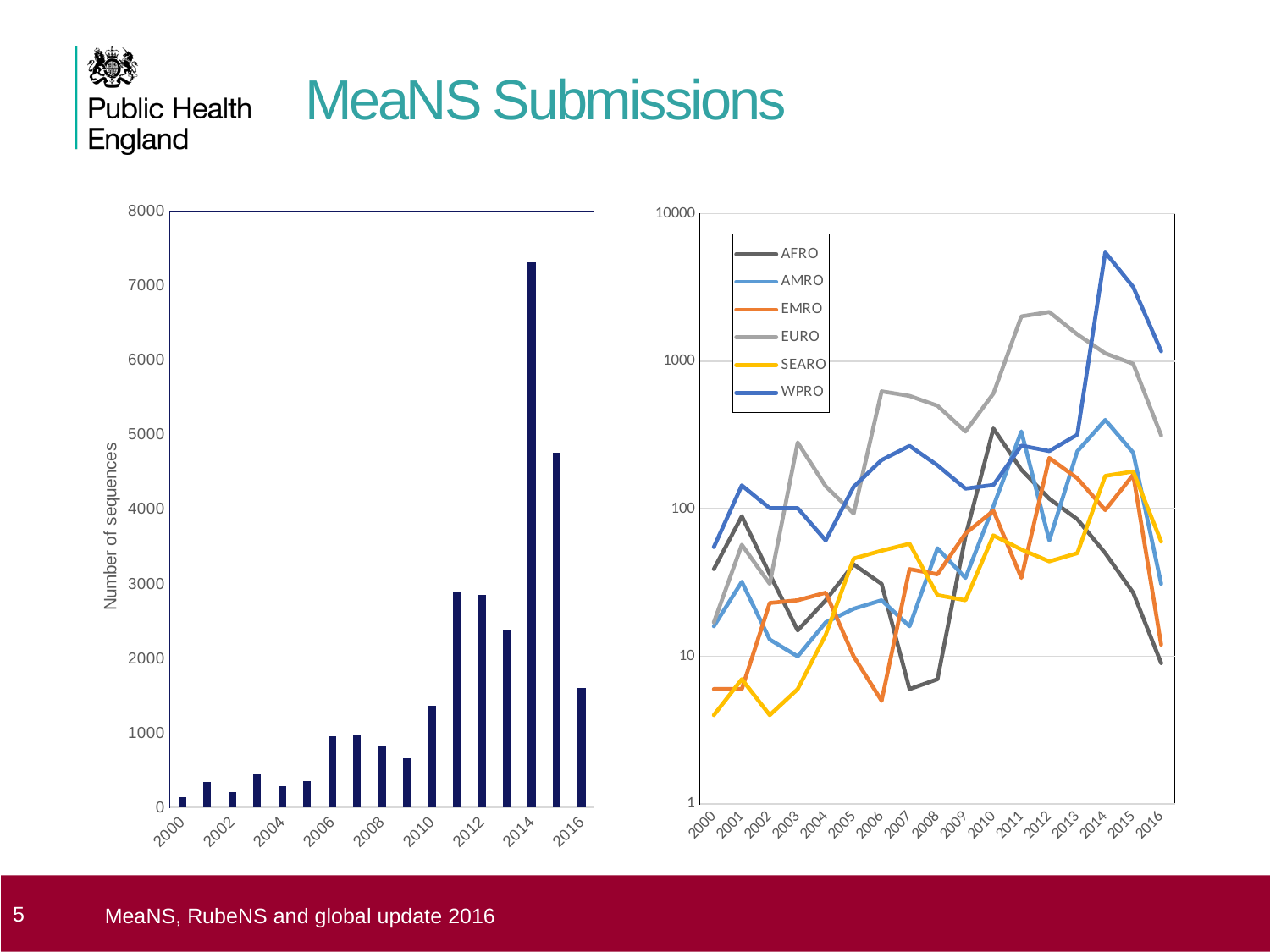
In the right line chart, is the value for WPRO in 2014 greater or less than 1000? greater How many series does the legend of the right line chart list? 6 What kind of chart is the left chart on the slide? bar chart In the left bar chart, is the value for 2016 greater or less than 1000? greater In the left bar chart, which year has the lowest number of sequences? 2000 In the left bar chart, is the value for 2015 greater or less than 5000? less What kind of chart is the right chart on the slide? line chart In the right line chart, which series has the highest value in 2014? WPRO In the left bar chart, which year has the highest number of sequences? 2014 In the left bar chart, which year has the larger value, 2012 or 2013? 2012